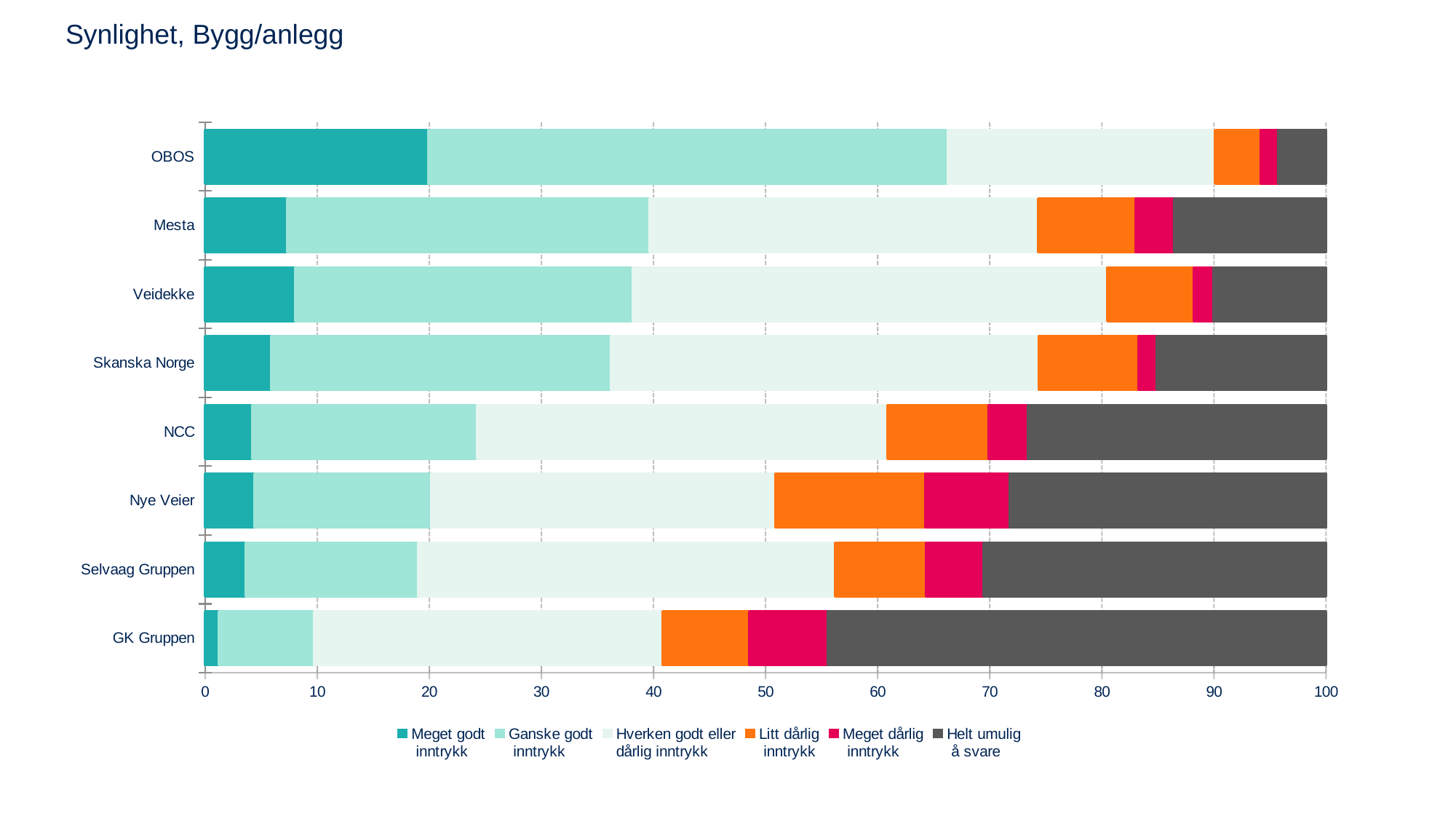
How many series does the legend list? 6 What kind of chart is shown on the slide? Stacked bar chart Which company has the largest 'Helt umulig å svare' segment? GK Gruppen Which has the larger 'Litt dårlig inntrykk' segment, Nye Veier or OBOS? Nye Veier What is the title of the slide? Synlighet, Bygg/anlegg Is the 'Helt umulig å svare' value for GK Gruppen greater or less than 40? greater Is the 'Meget godt inntrykk' value for OBOS greater or less than 10? greater Which company has the smallest 'Meget godt inntrykk' segment? GK Gruppen What is the total of the stacked bar for OBOS, as read from the axis? 100 Which company has the smallest 'Helt umulig å svare' segment? OBOS Which company has the largest 'Meget godt inntrykk' segment? OBOS How many companies are listed on the vertical axis of the chart? 8